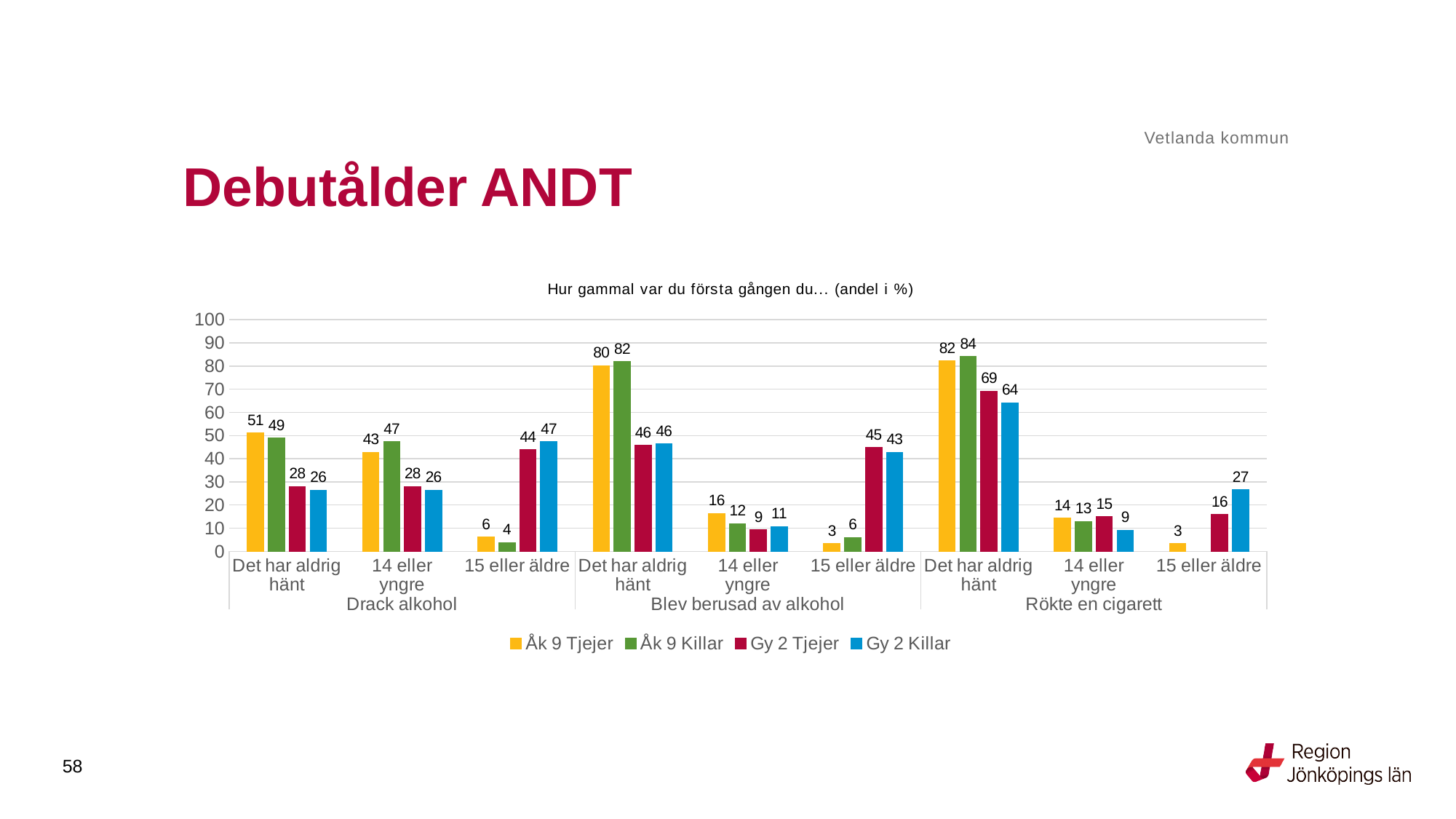
How many series does the legend list? 4 Which series has the highest value for 'Det har aldrig hänt' under 'Rökte en cigarett'? Åk 9 Killar What is the title of the chart? Hur gammal var du första gången du… (andel i %) What type of chart is shown on the slide? bar chart What is the value for Gy 2 Killar for '15 eller äldre' under 'Rökte en cigarett'? 27 Is the value for Gy 2 Tjejer for 'Det har aldrig hänt' under 'Rökte en cigarett' greater or less than 60? greater Which is larger for '14 eller yngre' under 'Drack alkohol': Åk 9 Tjejer or Gy 2 Killar? Åk 9 Tjejer How many category groups (questions) are shown along the x axis? 3 What is the value for Gy 2 Tjejer for '14 eller yngre' under 'Blev berusad av alkohol'? 9 What is the value for Åk 9 Tjejer for 'Det har aldrig hänt' under 'Drack alkohol'? 51 What is the difference between Åk 9 Killar and Gy 2 Tjejer for 'Det har aldrig hänt' under 'Blev berusad av alkohol'? 36 Which series has the lowest value for '15 eller äldre' under 'Drack alkohol'? Åk 9 Killar